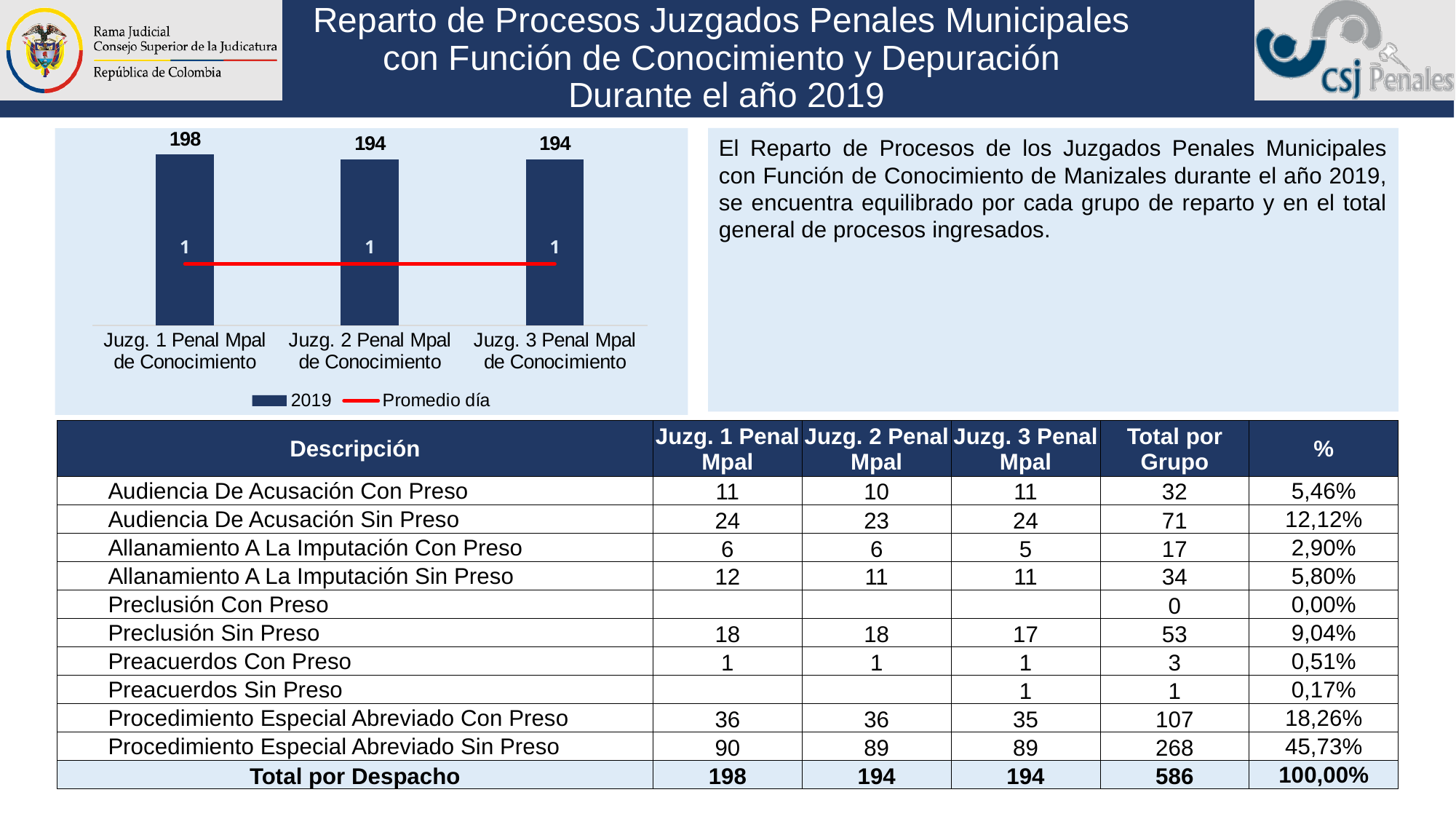
What is the difference between the 2019 values for Juzg. 1 Penal Mpal de Conocimiento and Juzg. 2 Penal Mpal de Conocimiento? 4 What is the 2019 value for Juzg. 1 Penal Mpal de Conocimiento in the chart? 198 What is the Promedio día value shown for Juzg. 2 Penal Mpal de Conocimiento? 1 How many juzgados (categories) are shown in the chart? 3 What is the 2019 value for Juzg. 3 Penal Mpal de Conocimiento in the chart? 194 What colour is the Promedio día line in the chart? Red What are the two entries in the chart legend? 2019 and Promedio día Which is larger, the 2019 value for Juzg. 1 Penal Mpal de Conocimiento or for Juzg. 3 Penal Mpal de Conocimiento? Juzg. 1 Penal Mpal de Conocimiento What kind of chart is shown on the slide? Bar chart with a line Which juzgado has the highest 2019 value in the chart? Juzg. 1 Penal Mpal de Conocimiento What is the 2019 value for Juzg. 2 Penal Mpal de Conocimiento in the chart? 194 How many series does the chart legend list? 2